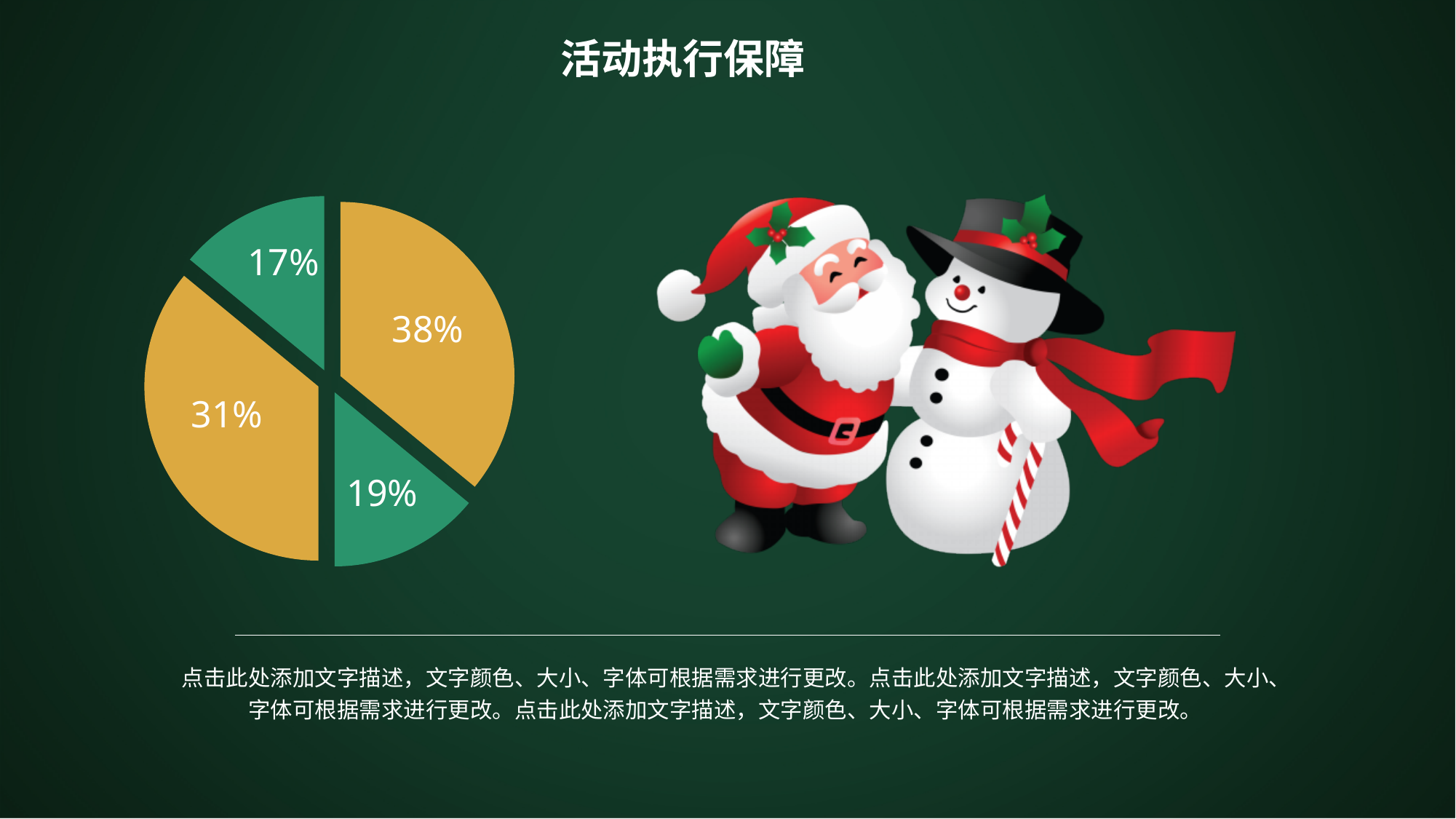
Which is larger in the pie chart, the slice in the upper-left or the slice in the lower-right? the lower-right slice (19%) What is the difference between the 31% slice and the 19% slice in the pie chart? 12% What is the title of the slide containing the pie chart? 活动执行保障 What kind of chart is shown on the slide? pie chart What is the combined share of the two gold-coloured slices in the pie chart? 69% What is the smallest share shown in the pie chart? 17% What is the difference between the largest slice (38%) and the smallest slice (17%) in the pie chart? 21% What is the combined share of the two green slices in the pie chart? 36% What percentage is shown on the slice in the upper-right of the pie chart? 38% What is the largest share shown in the pie chart? 38% How many slices does the pie chart have? 4 What percentage is shown on the slice in the lower-left of the pie chart? 31%